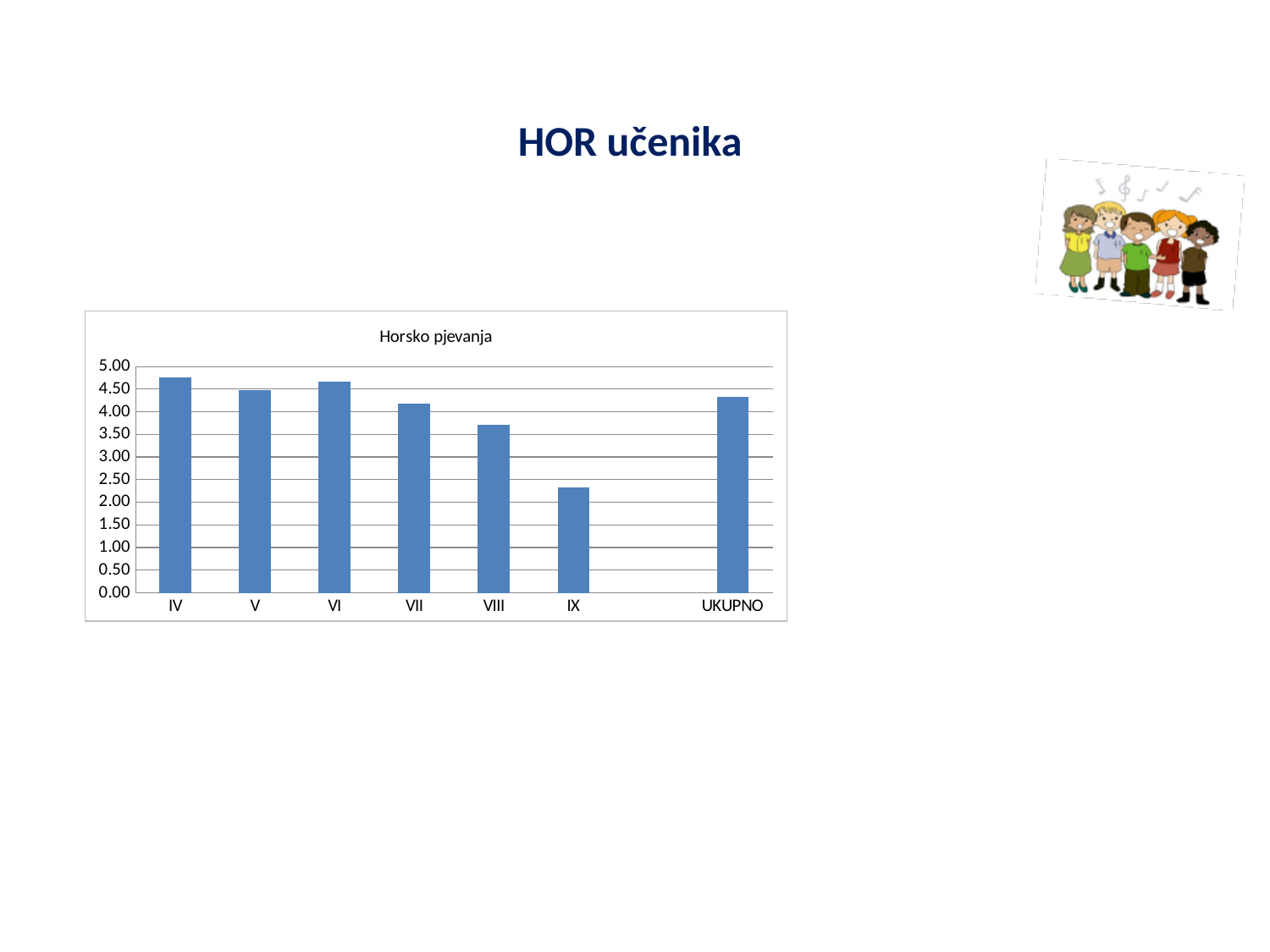
Do the values rise or fall from IV to IX along the x axis? fall Which category has the highest value in the chart? IV Which has the larger value, IX or UKUPNO? UKUPNO What is the title of the chart? Horsko pjevanja Is the value for UKUPNO greater or less than 4.00? greater What kind of chart is shown on the slide? bar chart Is the value for IX greater or less than 2.50? less Which category has the lowest value in the chart? IX Which has the larger value, VII or VIII? VII Is the value for VIII greater or less than 3.50? greater How many categories are shown on the x axis of the chart? 7